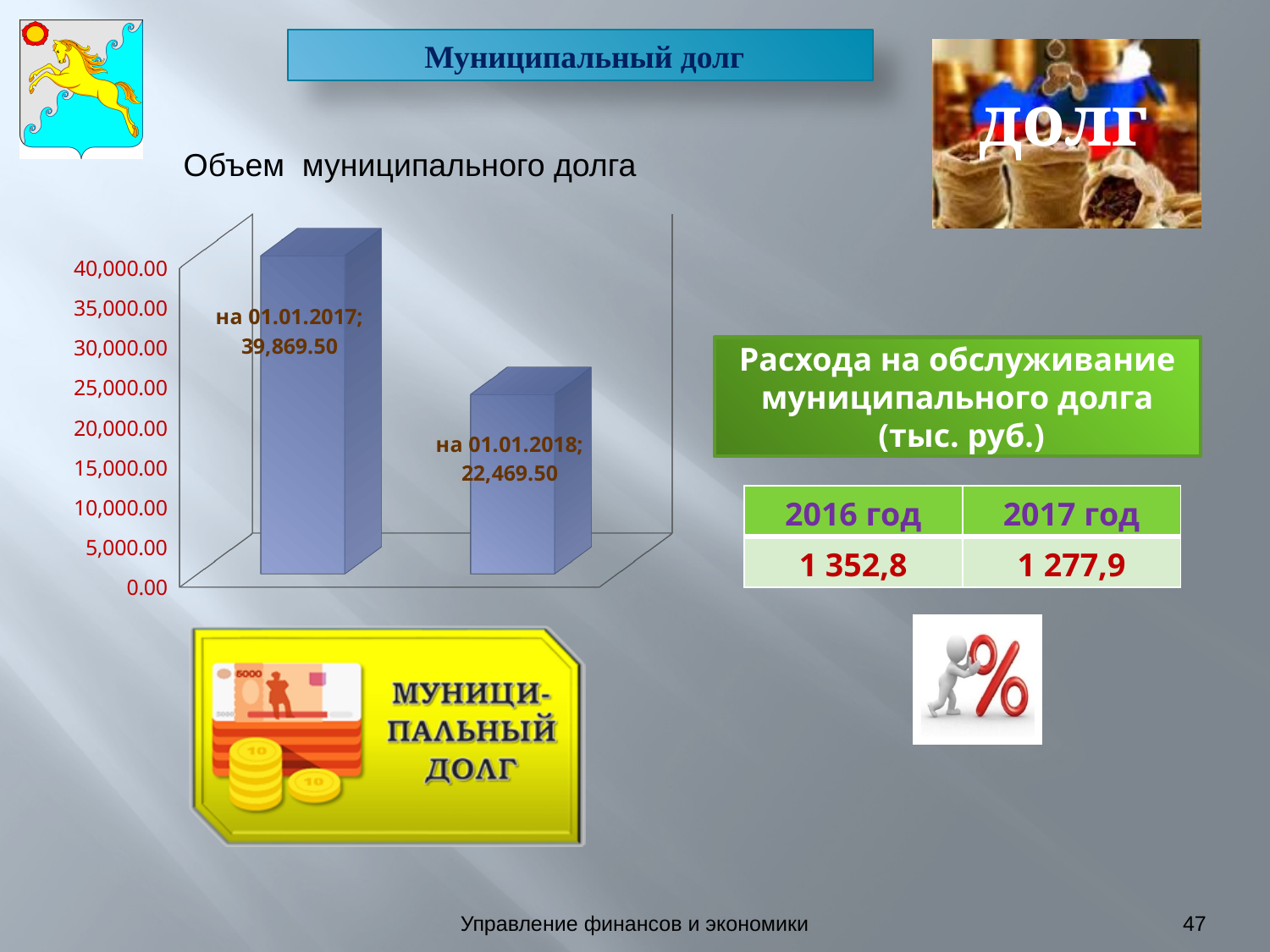
What is the value of municipal debt as of 01.01.2018 in the chart "Объем муниципального долга"? 22,469.50 Is the value for 01.01.2017 greater or less than 35,000.00? greater Which date has the higher municipal debt value in the chart? на 01.01.2017 What is the value of municipal debt as of 01.01.2017 in the chart "Объем муниципального долга"? 39,869.50 Does the municipal debt rise or fall from 01.01.2017 to 01.01.2018? fall What type of chart is used to show the volume of municipal debt? bar chart Is the value for 01.01.2018 greater or less than 25,000.00? less Which date has the lower municipal debt value in the chart? на 01.01.2018 By how much does the municipal debt on 01.01.2017 exceed the debt on 01.01.2018? 17,400.00 What is the title of the chart on the slide? Объем муниципального долга Is the municipal debt larger on 01.01.2017 or on 01.01.2018? 01.01.2017 How many bars are plotted in the chart "Объем муниципального долга"? 2